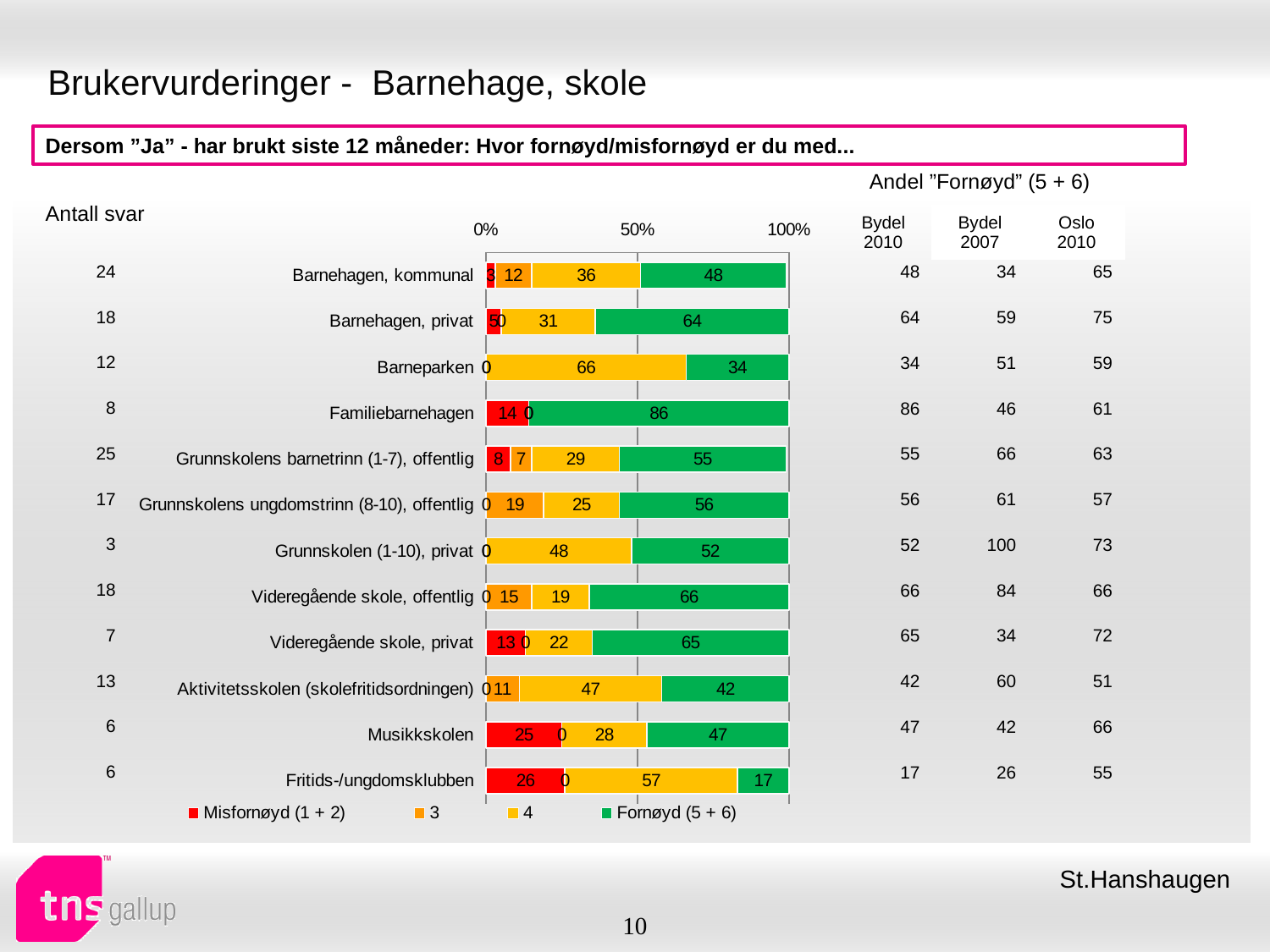
What is the first entry in the chart legend? Misfornøyd (1 + 2) What is the value of the '4' segment for Barneparken? 66 What is the difference between the Fornøyd (5 + 6) values for Barnehagen, privat and Barnehagen, kommunal? 16 How many series does the chart legend list? 4 Which category has the lowest Fornøyd (5 + 6) value? Fritids-/ungdomsklubben What is the Misfornøyd (1 + 2) value for Fritids-/ungdomsklubben? 26 How many categories (rows) does the bar chart show? 12 What is the Fornøyd (5 + 6) value for Barnehagen, kommunal? 48 What is the Misfornøyd (1 + 2) value for Musikkskolen? 25 Which category has the highest Fornøyd (5 + 6) value? Familiebarnehagen Which has the larger Fornøyd (5 + 6) value, Barnehagen, privat or Barneparken? Barnehagen, privat What kind of chart is shown on the slide? Stacked bar chart